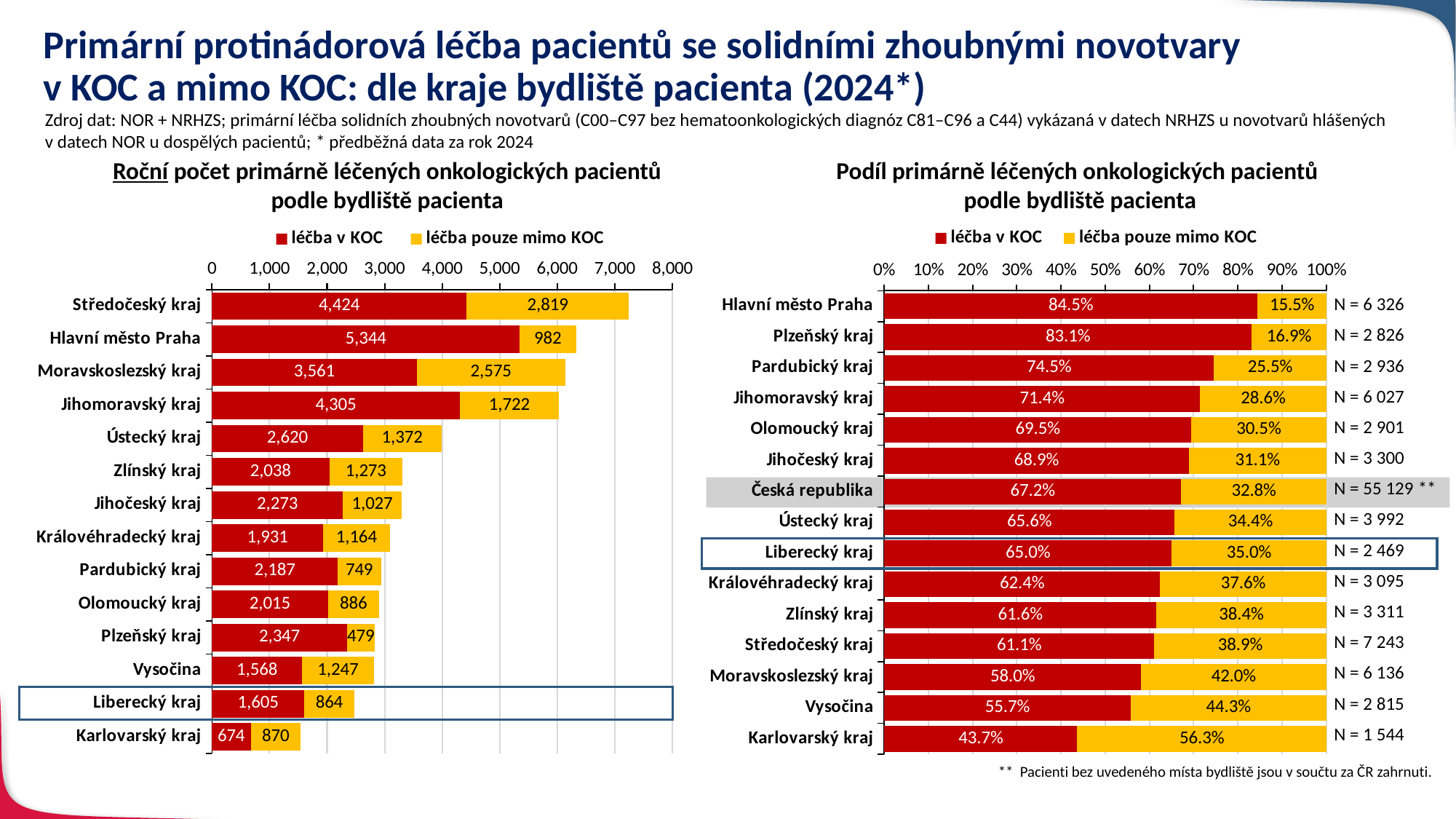
In the left chart (Roční počet primárně léčených onkologických pacientů podle bydliště pacienta), what is the total of the stacked bar for Liberecký kraj? 2,469 In the right chart (Podíl primárně léčených onkologických pacientů podle bydliště pacienta), what is the share of léčba pouze mimo KOC for Karlovarský kraj? 56.3% How many regions are shown in the left chart (Roční počet primárně léčených onkologických pacientů podle bydliště pacienta)? 14 In the right chart (Podíl primárně léčených onkologických pacientů podle bydliště pacienta), which has the larger share of léčba v KOC: Plzeňský kraj or Pardubický kraj? Plzeňský kraj In the left chart (Roční počet primárně léčených onkologických pacientů podle bydliště pacienta), what is the value of léčba v KOC for Jihomoravský kraj? 4,305 In the right chart (Podíl primárně léčených onkologických pacientů podle bydliště pacienta), what is the share of léčba v KOC for Česká republika? 67.2% In the left chart (Roční počet primárně léčených onkologických pacientů podle bydliště pacienta), which region has the lowest value for léčba v KOC? Karlovarský kraj What kind of chart is the right chart (Podíl primárně léčených onkologických pacientů podle bydliště pacienta)? bar chart How many series does the legend of the right chart (Podíl primárně léčených onkologických pacientů podle bydliště pacienta) list? 2 In the left chart (Roční počet primárně léčených onkologických pacientů podle bydliště pacienta), what is the value of léčba pouze mimo KOC for Vysočina? 1,247 In the left chart (Roční počet primárně léčených onkologických pacientů podle bydliště pacienta), what is the difference between léčba v KOC and léčba pouze mimo KOC for Středočeský kraj? 1,605 In the left chart (Roční počet primárně léčených onkologických pacientů podle bydliště pacienta), which region has the highest value for léčba v KOC? Hlavní město Praha